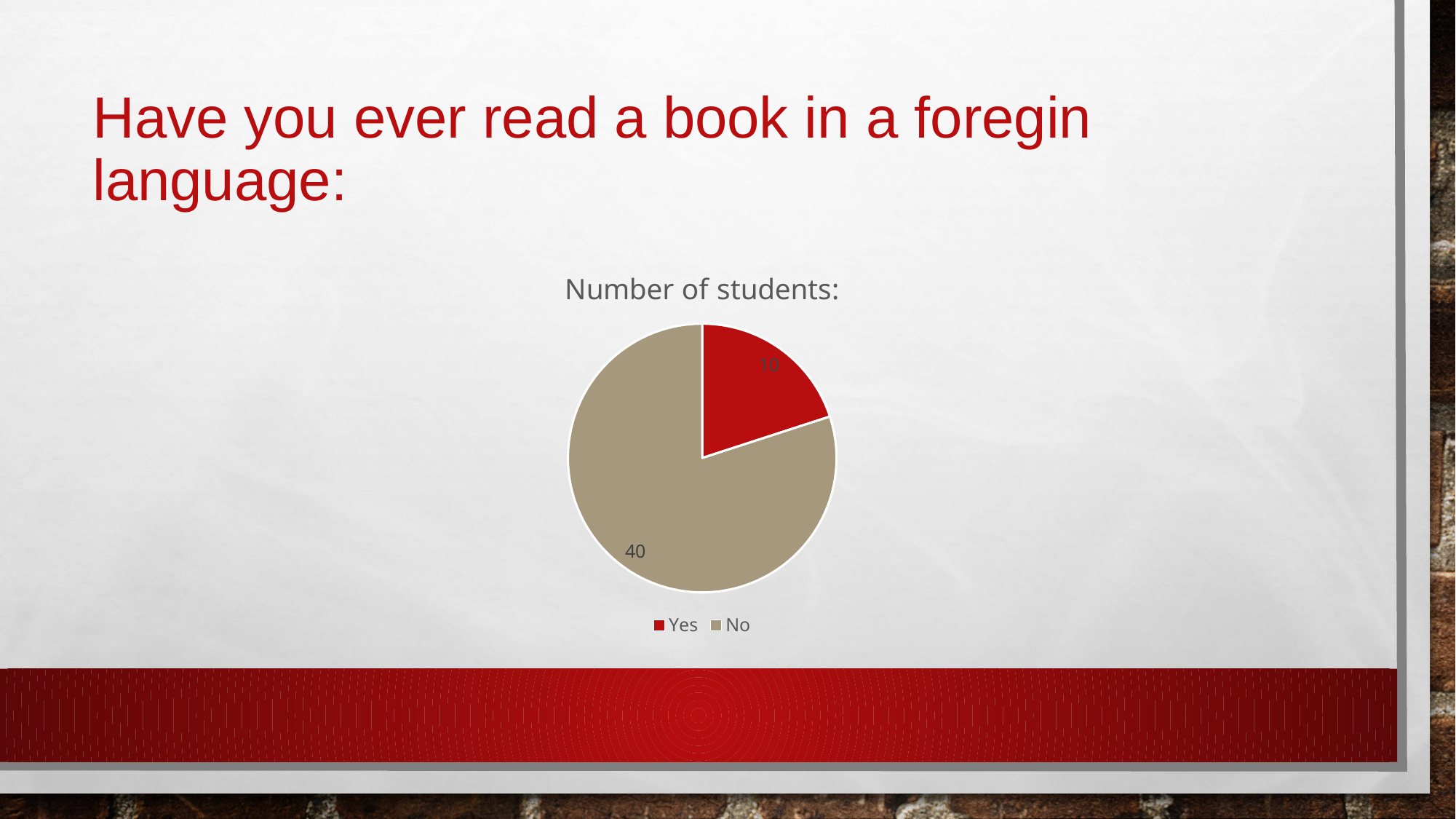
What kind of chart is shown on the slide? pie chart Which category has the largest slice? No Which is larger, the value for Yes or the value for No? No What is the total number of students represented in the pie chart? 50 Which category has the smallest slice? Yes How many entries does the legend list? 2 How many students answered Yes? 10 How many more students answered No than Yes? 30 How many students answered No? 40 How many slices does the pie chart have? 2 What share of the pie does the Yes slice represent? 20% What is the chart's title? Number of students: